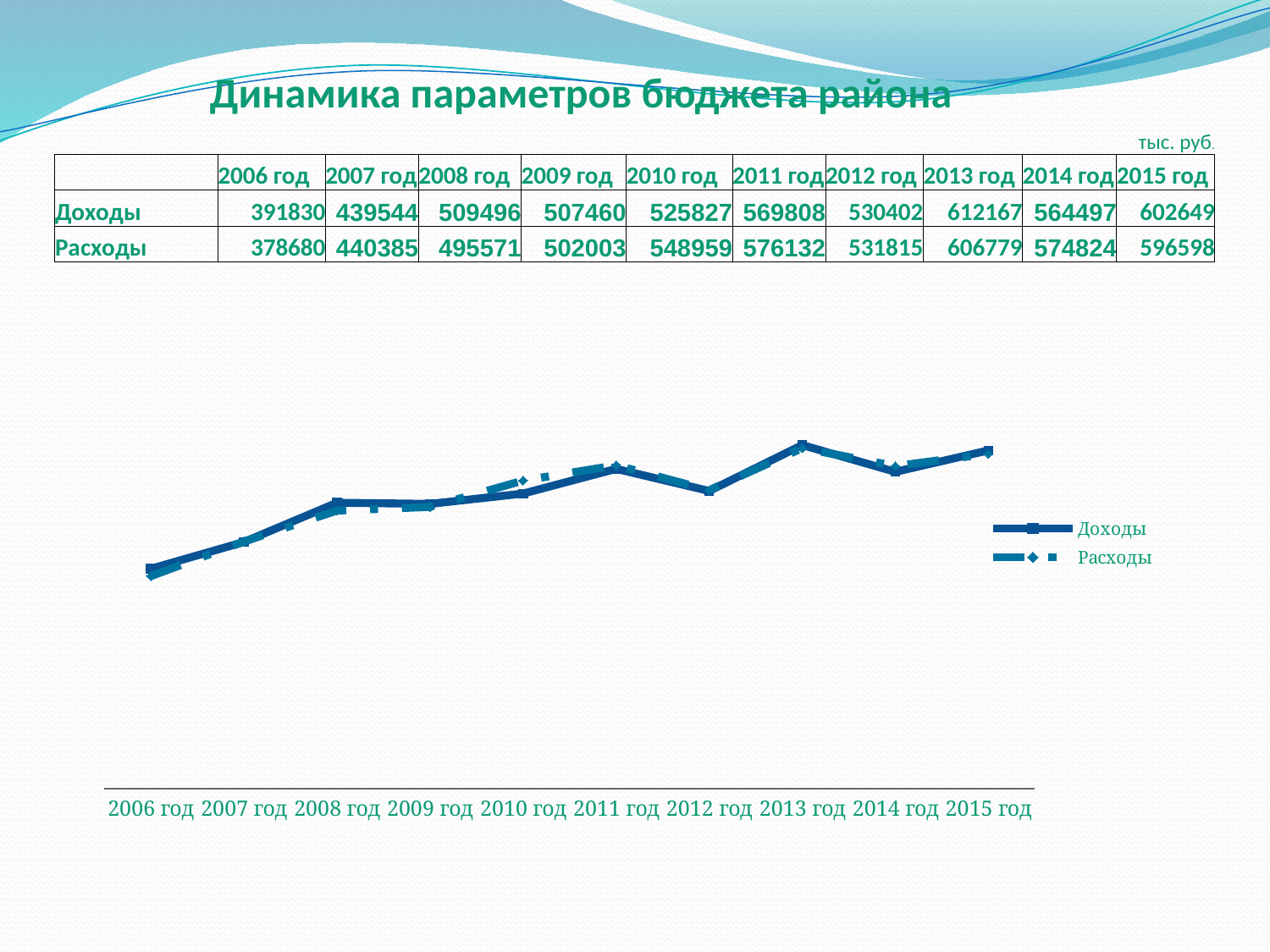
What is the title of the chart on the slide? Динамика параметров бюджета района How many series does the chart legend list? 2 What is the value of Доходы for 2013 год? 612167 What is the value of Доходы for 2006 год? 391830 How many years are plotted along the x axis of the chart? 10 Do the values of Доходы generally rise or fall from 2006 год to 2015 год? rise In which year is Доходы highest? 2013 год In which year is Расходы lowest? 2006 год What type of chart is shown on the slide? line chart What is the difference between Доходы and Расходы in 2013 год? 5388 What is the value of Расходы for 2010 год? 548959 Which is larger in 2010 год, Доходы or Расходы? Расходы